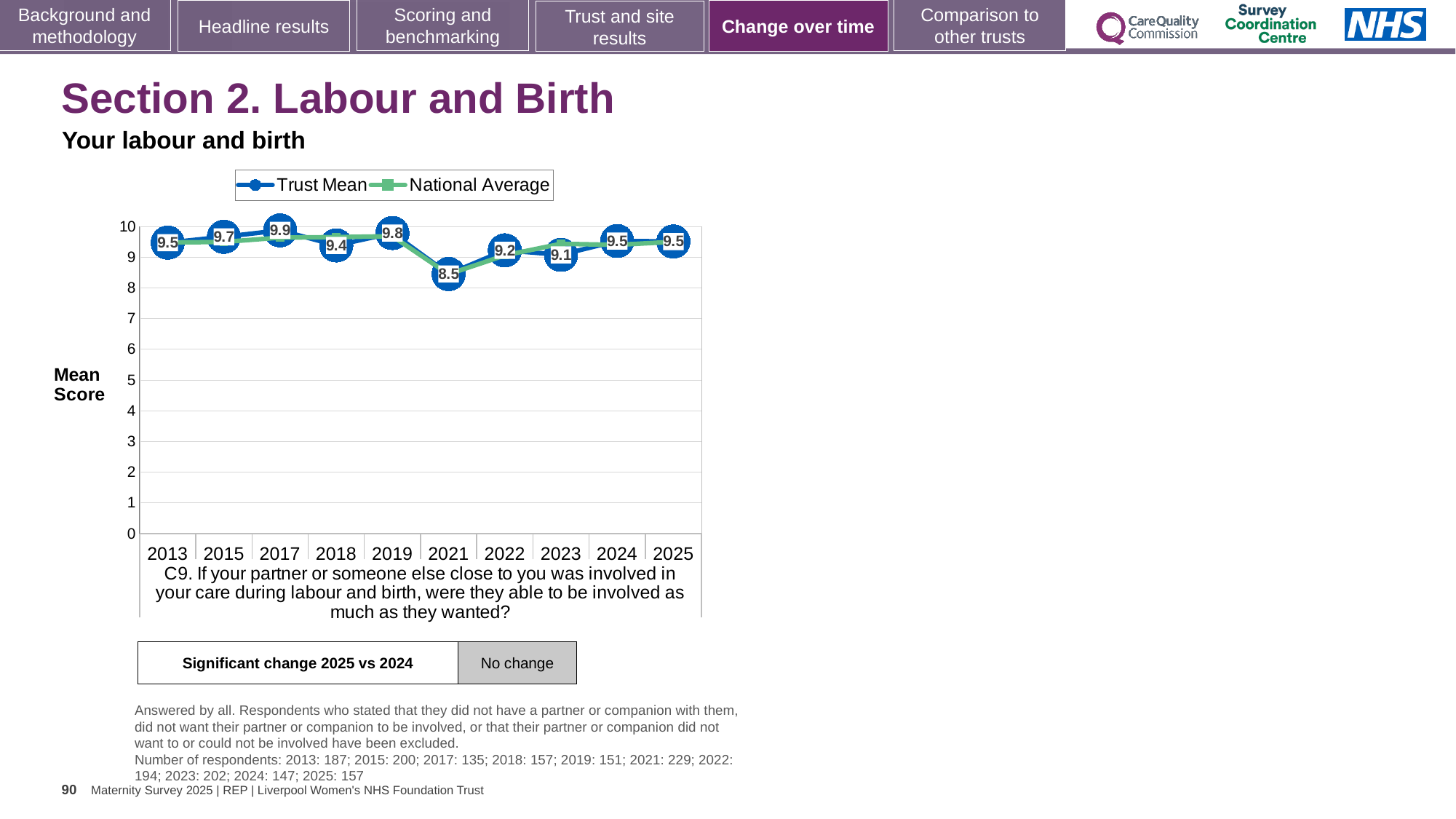
Is the National Average value for 2021 greater or less than 9? less Does the Trust Mean rise or fall from 2019 to 2021? Fall How many years are shown on the x axis? 10 What is the Trust Mean value for 2021? 8.5 In which year is the Trust Mean highest? 2017 What is the difference between the Trust Mean in 2017 and in 2021? 1.4 What is the Trust Mean value for 2017? 9.9 How many series does the legend list? 2 What is the Trust Mean value for 2025? 9.5 In which year is the Trust Mean lowest? 2021 What kind of chart is shown on the slide? Line chart Which year has the larger Trust Mean, 2018 or 2019? 2019